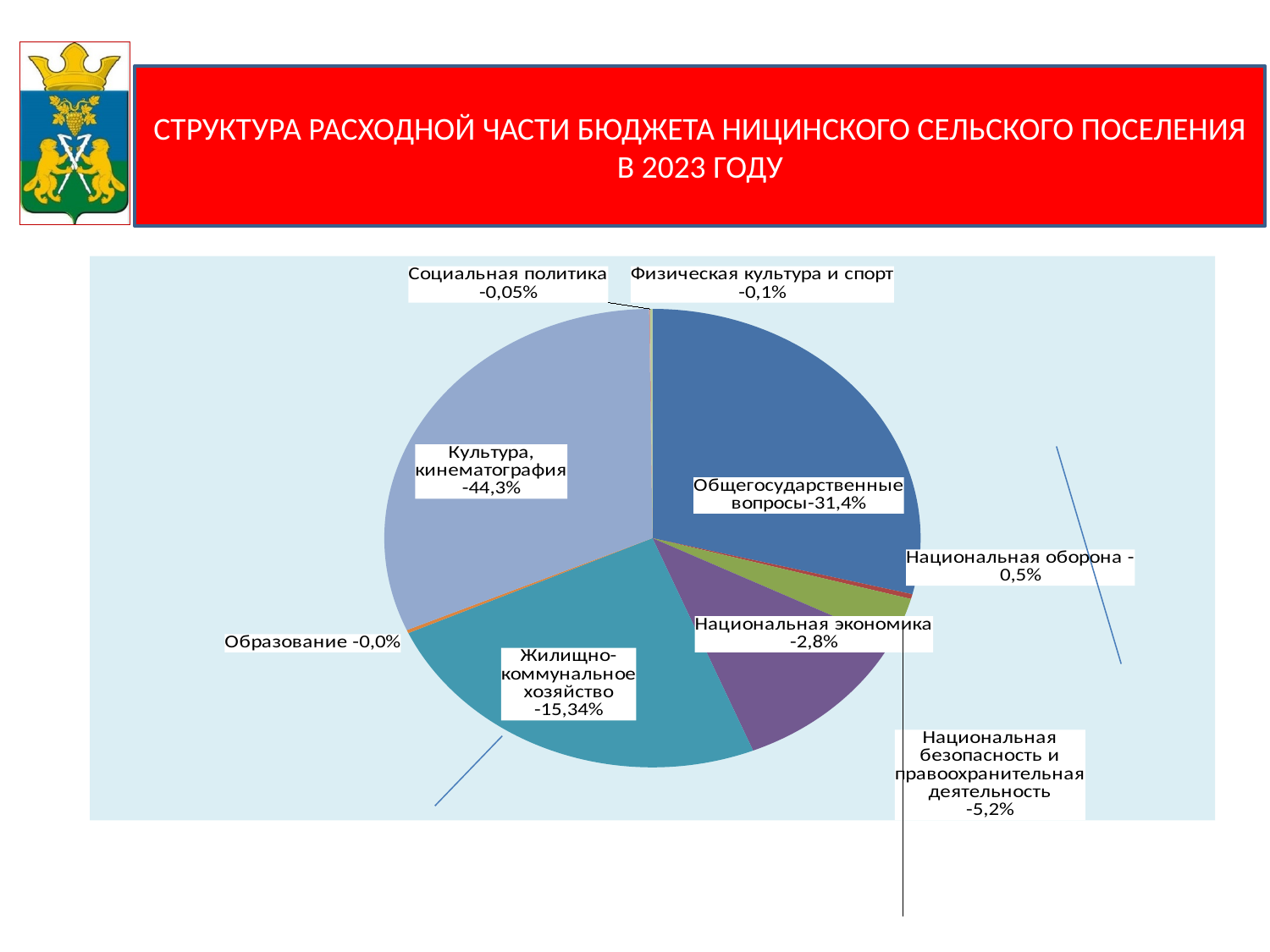
What share is shown for Национальная оборона? 0,5% How many categories are shown in the pie chart? 9 What year does the chart title say the budget structure refers to? 2023 What share is shown for Жилищно-коммунальное хозяйство? 15,34% What share of the budget expenditure goes to Культура, кинематография? 44,3% Which category has the smallest share of the pie? Образование What share is shown for Общегосударственные вопросы? 31,4% What kind of chart is shown on the slide? pie chart What is the difference in percentage points between Культура, кинематография and Общегосударственные вопросы? 12,9 Which category has the largest share of the pie? Культура, кинематография What share is shown for Национальная безопасность и правоохранительная деятельность? 5,2%